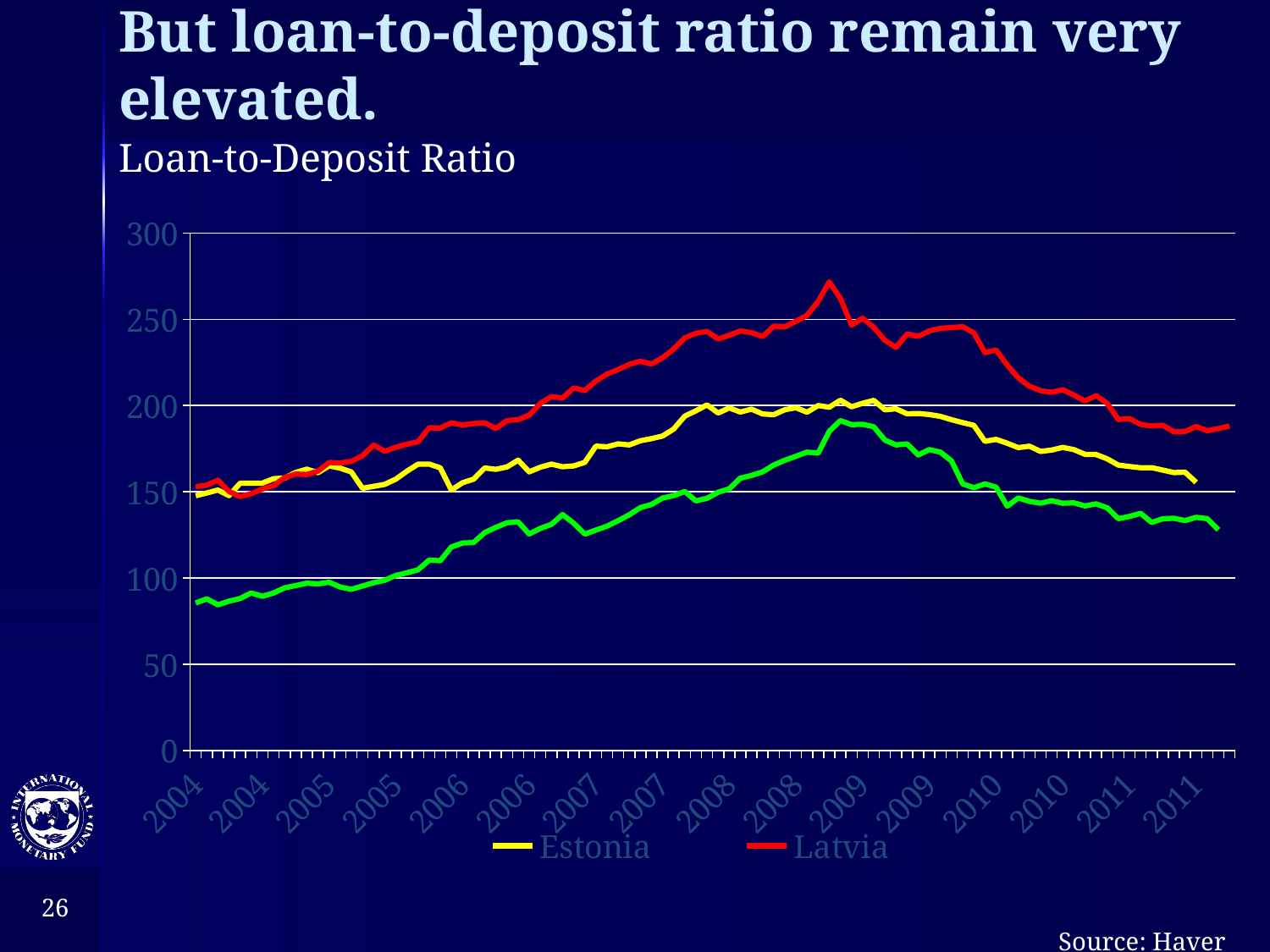
Is the value for Estonia at the start of 2006 greater or less than 200? less What is the title of the chart? Loan-to-Deposit Ratio Does the value for Latvia rise or fall between 2004 and 2008? rise Is the peak value for Latvia greater or less than 250? greater Is the value for Latvia at the end of 2011 greater or less than 200? less Which series listed in the legend reaches the highest value on the chart? Latvia In 2008, which is higher, the value for Latvia or the value for Estonia? Latvia How many series does the chart legend list? 2 What kind of chart is shown on the slide? line chart Does the value for Latvia rise or fall between 2009 and 2011? fall